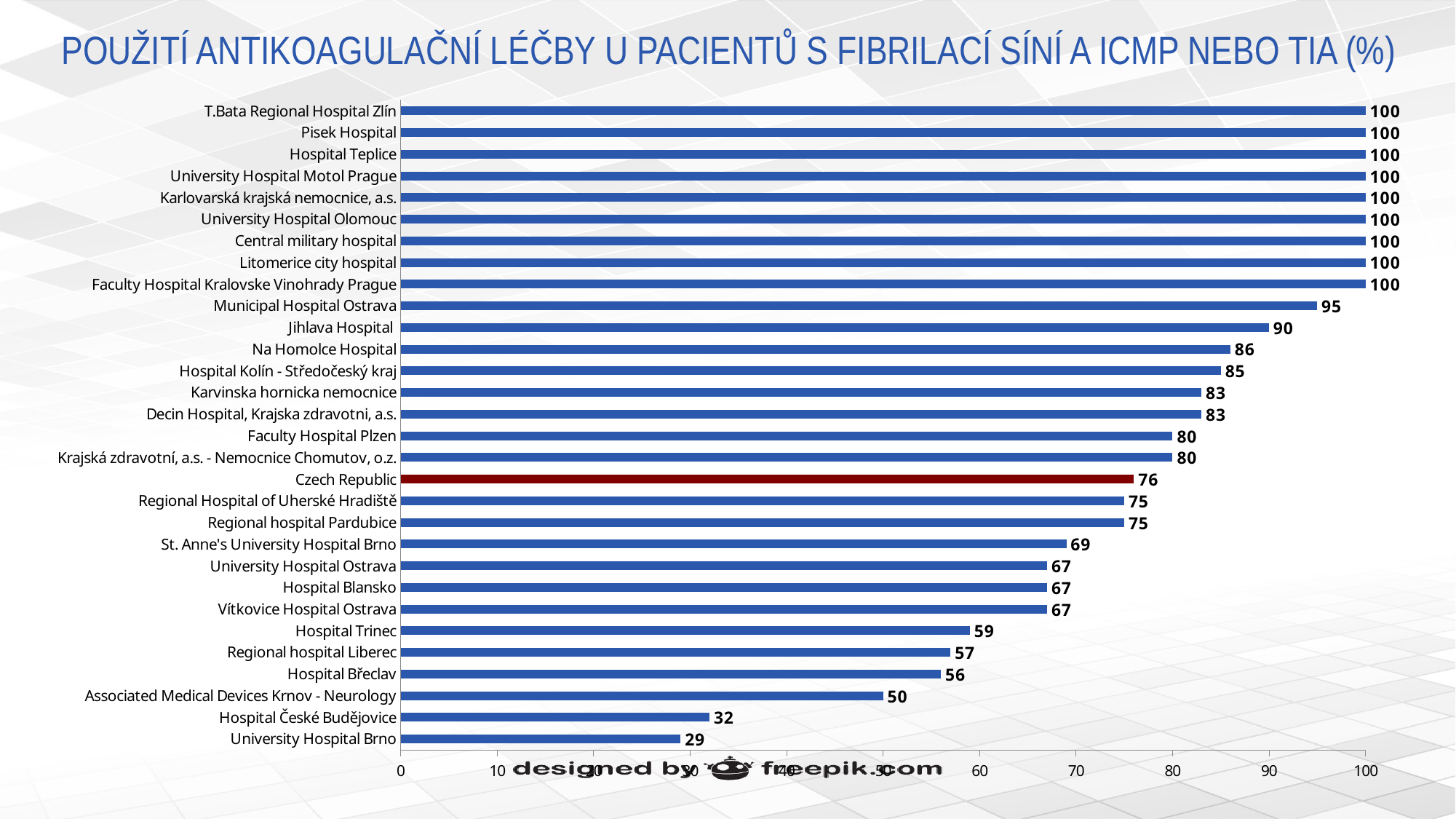
How many categories are shown in the chart? 30 Which category's bar is shown in a different colour (dark red) from the others? Czech Republic Which is larger, the value for Na Homolce Hospital or the value for Faculty Hospital Plzen? Na Homolce Hospital What is the value for Jihlava Hospital? 90 Which is larger, the value for Regional hospital Liberec or the value for St. Anne's University Hospital Brno? St. Anne's University Hospital Brno Which category has the lowest value? University Hospital Brno What is the value for Czech Republic? 76 What is the difference between the values for Hospital Trinec and University Hospital Brno? 30 What is the value for Associated Medical Devices Krnov - Neurology? 50 What is the difference between the values for Municipal Hospital Ostrava and Czech Republic? 19 What kind of chart is shown on the slide? Bar chart What is the value for Hospital České Budějovice? 32